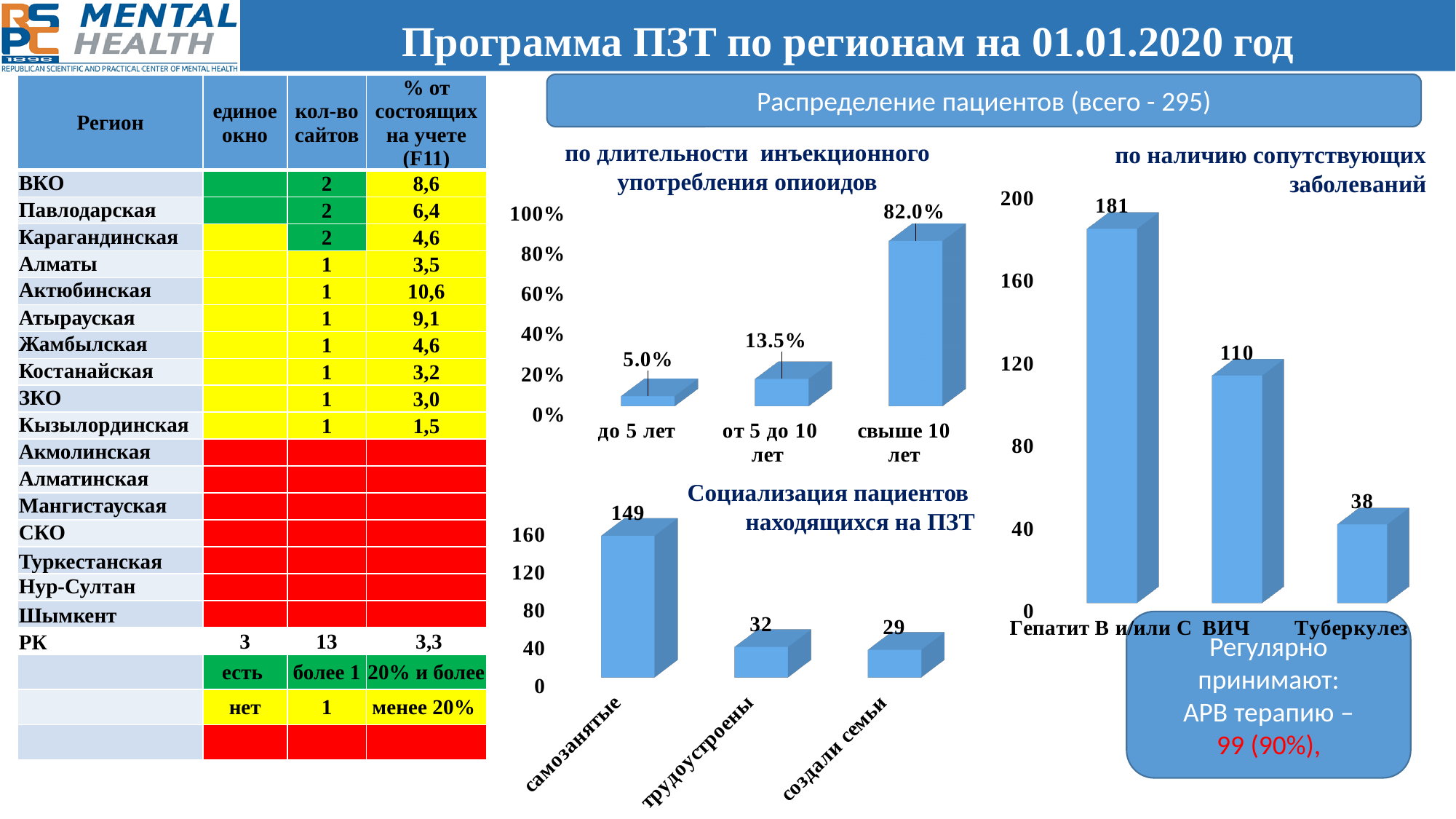
In the chart 'Социализация пациентов находящихся на ПЗТ', which category has the highest value? самозанятые In the chart 'Социализация пациентов находящихся на ПЗТ', what is the value for 'самозанятые'? 149 In the chart 'по длительности инъекционного употребления опиоидов', what is the value for 'свыше 10 лет'? 82.0% In the chart 'по наличию сопутствующих заболеваний', what is the value for 'ВИЧ'? 110 In the chart 'по длительности инъекционного употребления опиоидов', which category has the lowest value? до 5 лет In the chart 'по длительности инъекционного употребления опиоидов', what is the value for 'до 5 лет'? 5.0% In the chart 'Социализация пациентов находящихся на ПЗТ', how many categories are shown? 3 In the chart 'по наличию сопутствующих заболеваний', do the values rise or fall from left to right? fall In the chart 'по наличию сопутствующих заболеваний', what is the difference between 'Гепатит В и/или С' and 'Туберкулез'? 143 In the chart 'Социализация пациентов находящихся на ПЗТ', which is larger: 'трудоустроены' or 'создали семьи'? трудоустроены What type of chart is 'по наличию сопутствующих заболеваний'? bar chart In the chart 'по длительности инъекционного употребления опиоидов', what is the difference between 'свыше 10 лет' and 'от 5 до 10 лет'? 68.5%